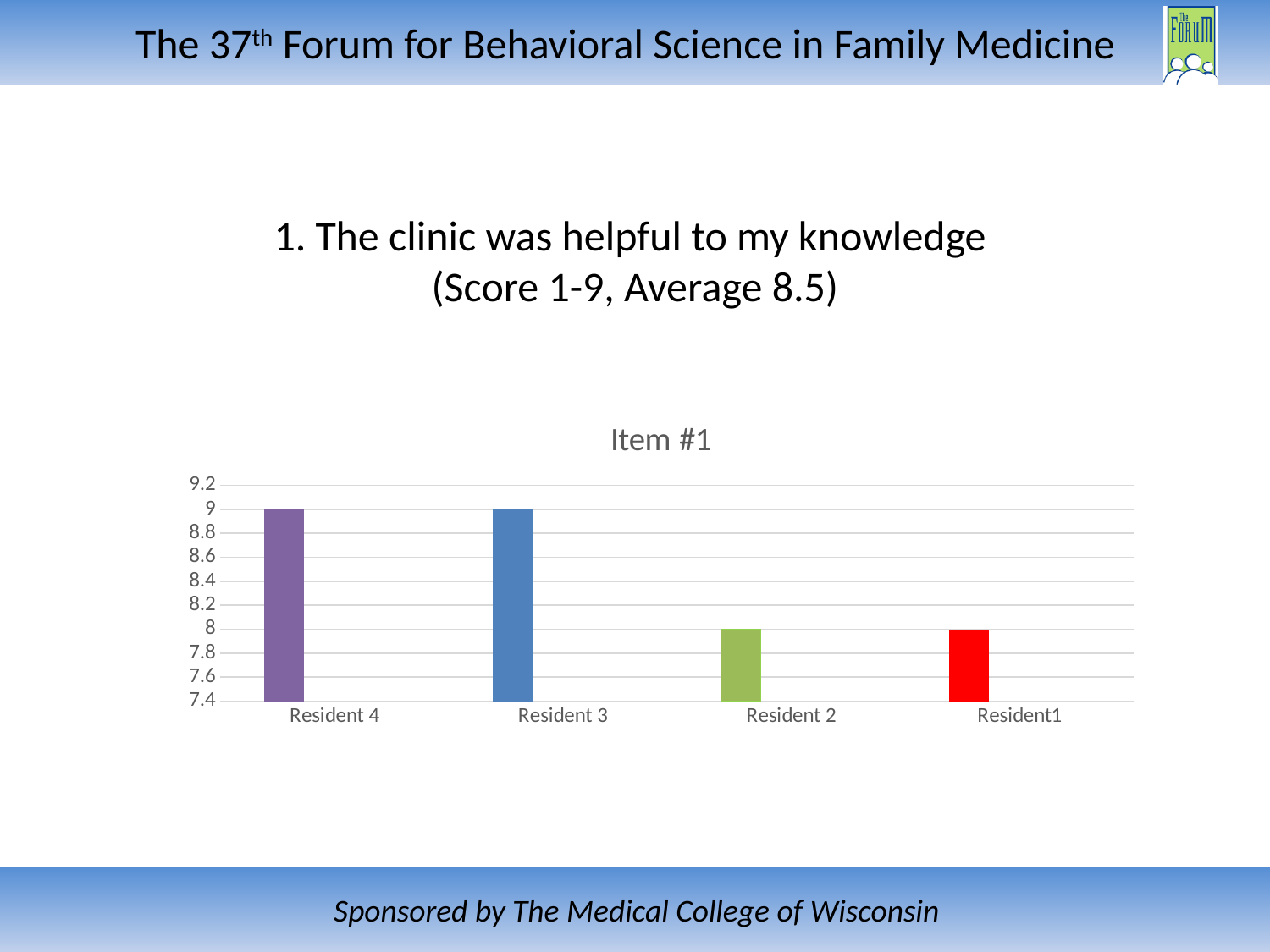
Which is larger in the Item #1 chart, the value for Resident1 or the value for Resident 3? Resident 3 Which is larger in the Item #1 chart, the value for Resident 4 or the value for Resident 2? Resident 4 What is the value for Resident1 in the Item #1 chart? 8 What kind of chart is the Item #1 chart? bar chart What is the difference between the values for Resident 3 and Resident1 in the Item #1 chart? 1 How many categories are shown in the Item #1 chart? 4 What is the value for Resident 4 in the Item #1 chart? 9 What is the value for Resident 2 in the Item #1 chart? 8 What colour is the bar for Resident1 in the Item #1 chart? red Is the value for Resident 3 in the Item #1 chart greater or less than 8.6? greater Is the value for Resident 2 in the Item #1 chart greater or less than 8.4? less What is the value for Resident 3 in the Item #1 chart? 9